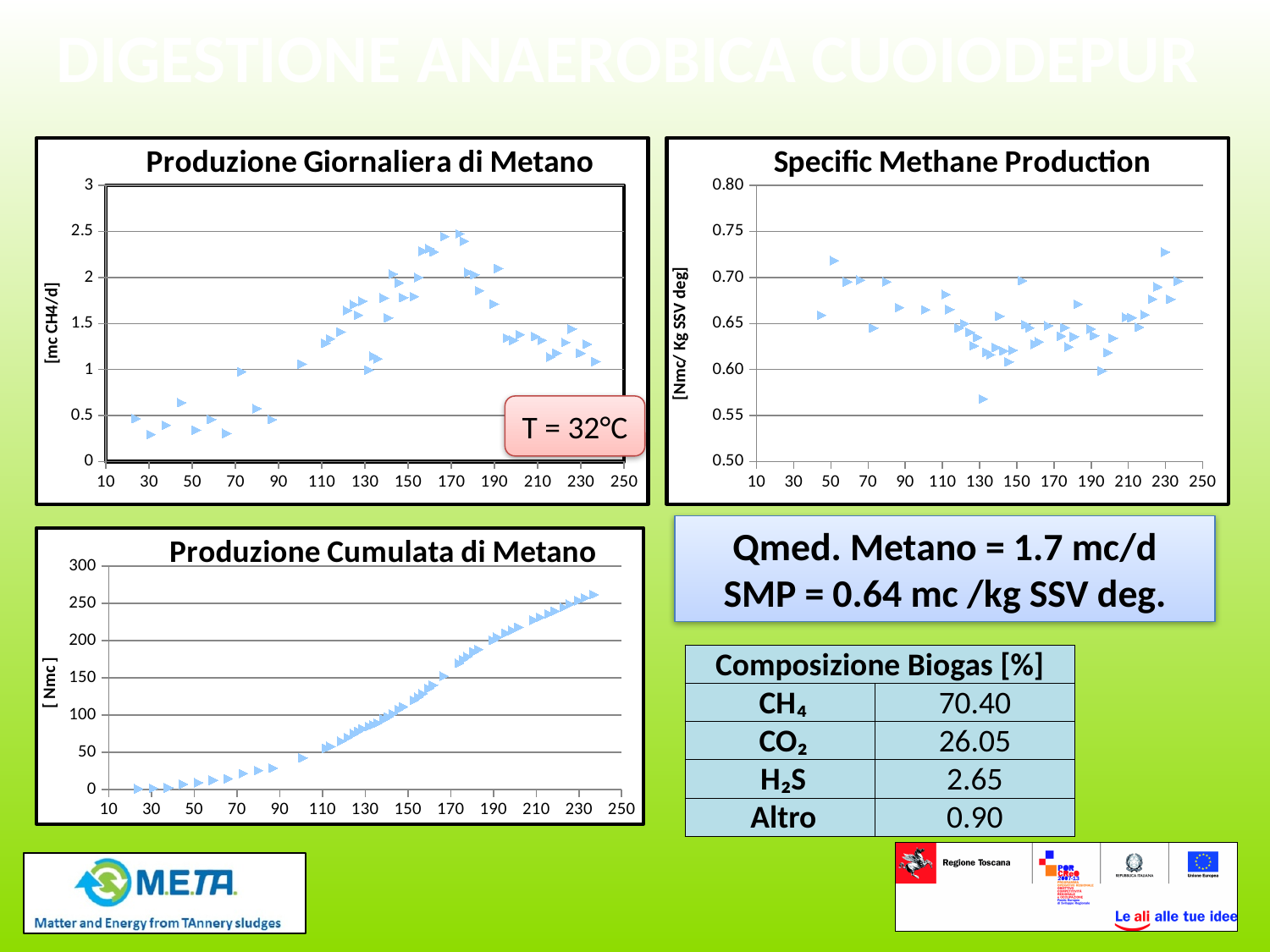
What is the y-axis label of the "Specific Methane Production" chart? [Nmc/ Kg SSV deg] In the "Specific Methane Production" chart, is the lowest plotted value greater or less than 0.60? less In the "Produzione Giornaliera di Metano" chart, is the value at x = 170 greater or less than 2? greater What is the title of the chart at the bottom left of the slide? Produzione Cumulata di Metano In the "Produzione Giornaliera di Metano" chart, do the values generally rise or fall between x = 10 and x = 170? rise What kind of chart is "Specific Methane Production"? scatter chart In the "Produzione Cumulata di Metano" chart, is the value at x = 230 greater or less than 200? greater What kind of chart is "Produzione Giornaliera di Metano"? scatter chart In the "Produzione Cumulata di Metano" chart, do the values rise or fall along the x axis? rise